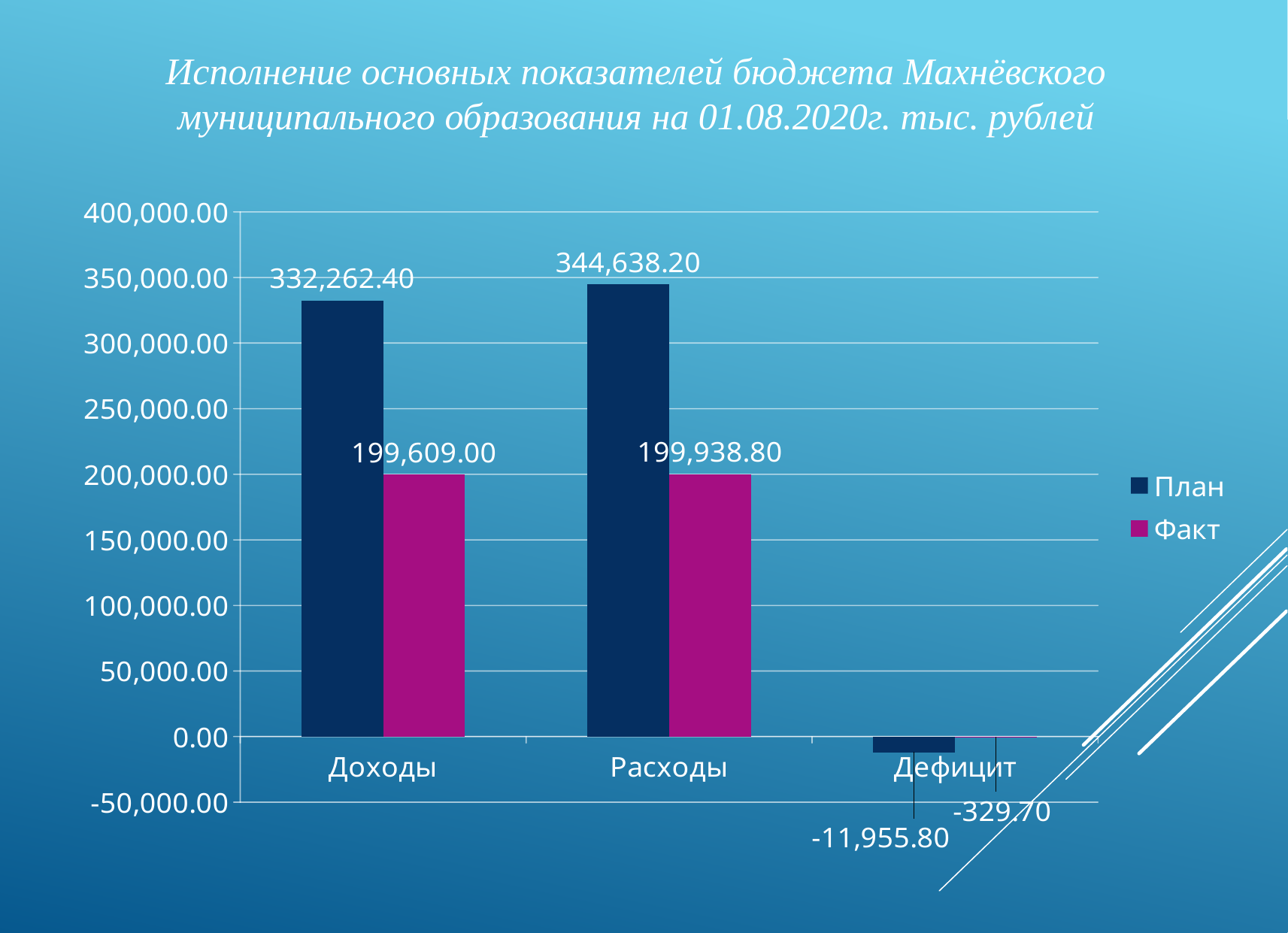
How many series does the legend list? 2 What is the difference between the План values for Расходы and Доходы? 12,375.80 What is the difference between the План and Факт values for Доходы? 132,653.40 Is the Факт value for Доходы greater or less than 250,000.00? less What is the Факт value for Расходы? 199,938.80 Which category has the highest План value? Расходы What is the План value for Дефицит? -11,955.80 Which category has the lowest Факт value? Дефицит What is the План value for Доходы? 332,262.40 What kind of chart is shown on the slide? Bar chart What is the Факт value for Дефицит? -329.70 Which is larger for Расходы: the План value or the Факт value? План